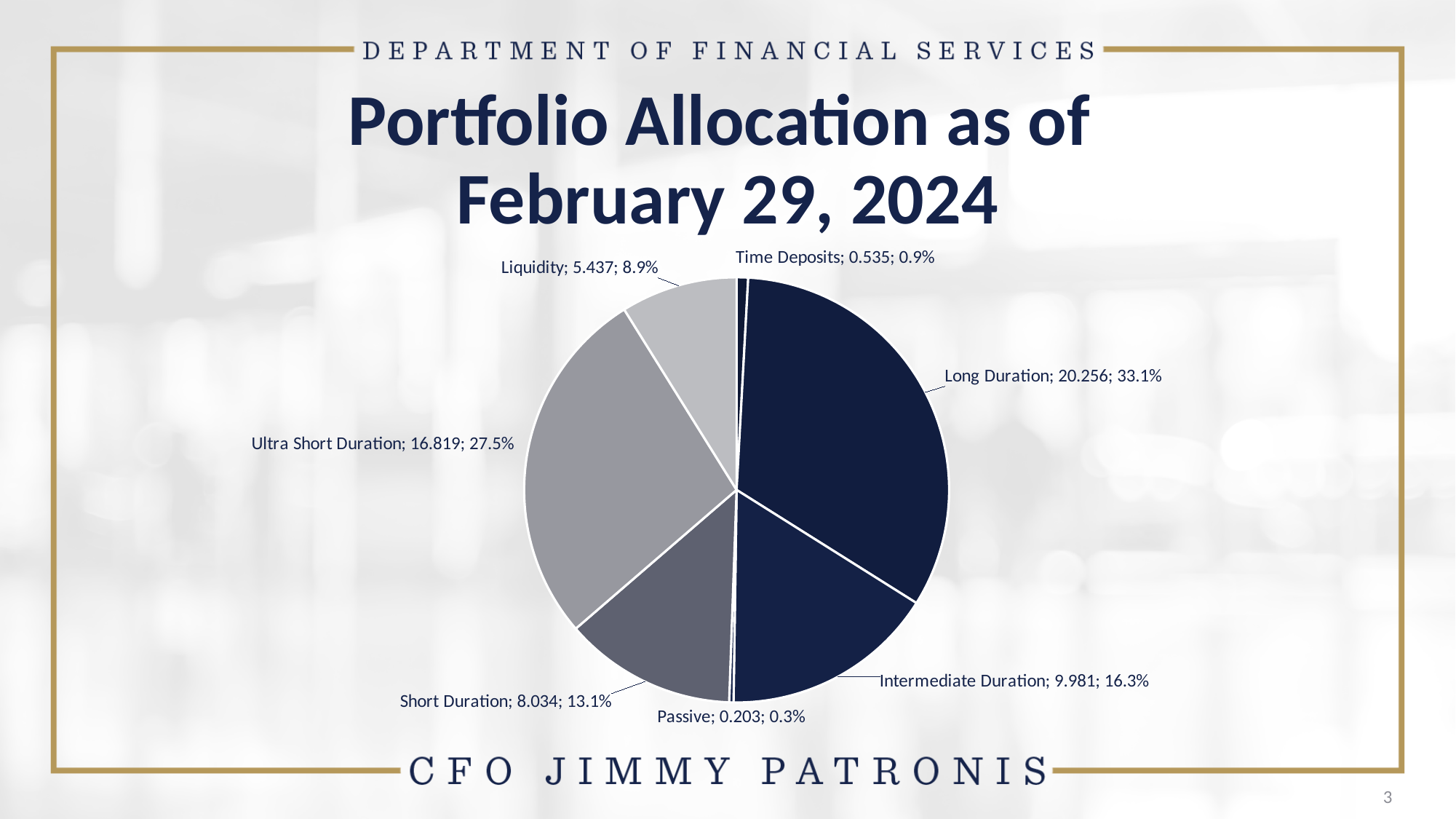
What is the value shown for Passive? 0.203 What percentage share does Time Deposits have? 0.9% What is the title of the slide containing the chart? Portfolio Allocation as of February 29, 2024 Which is larger, the value for Short Duration or the value for Liquidity? Short Duration What is the difference between the values for Long Duration and Ultra Short Duration? 3.437 What kind of chart is shown on the slide? Pie chart How many categories are shown in the pie chart? 7 What is the value shown for Long Duration? 20.256 Which category has the smallest slice of the pie? Passive Which category has the largest slice of the pie? Long Duration What is the value shown for Intermediate Duration? 9.981 What percentage share does Ultra Short Duration have? 27.5%